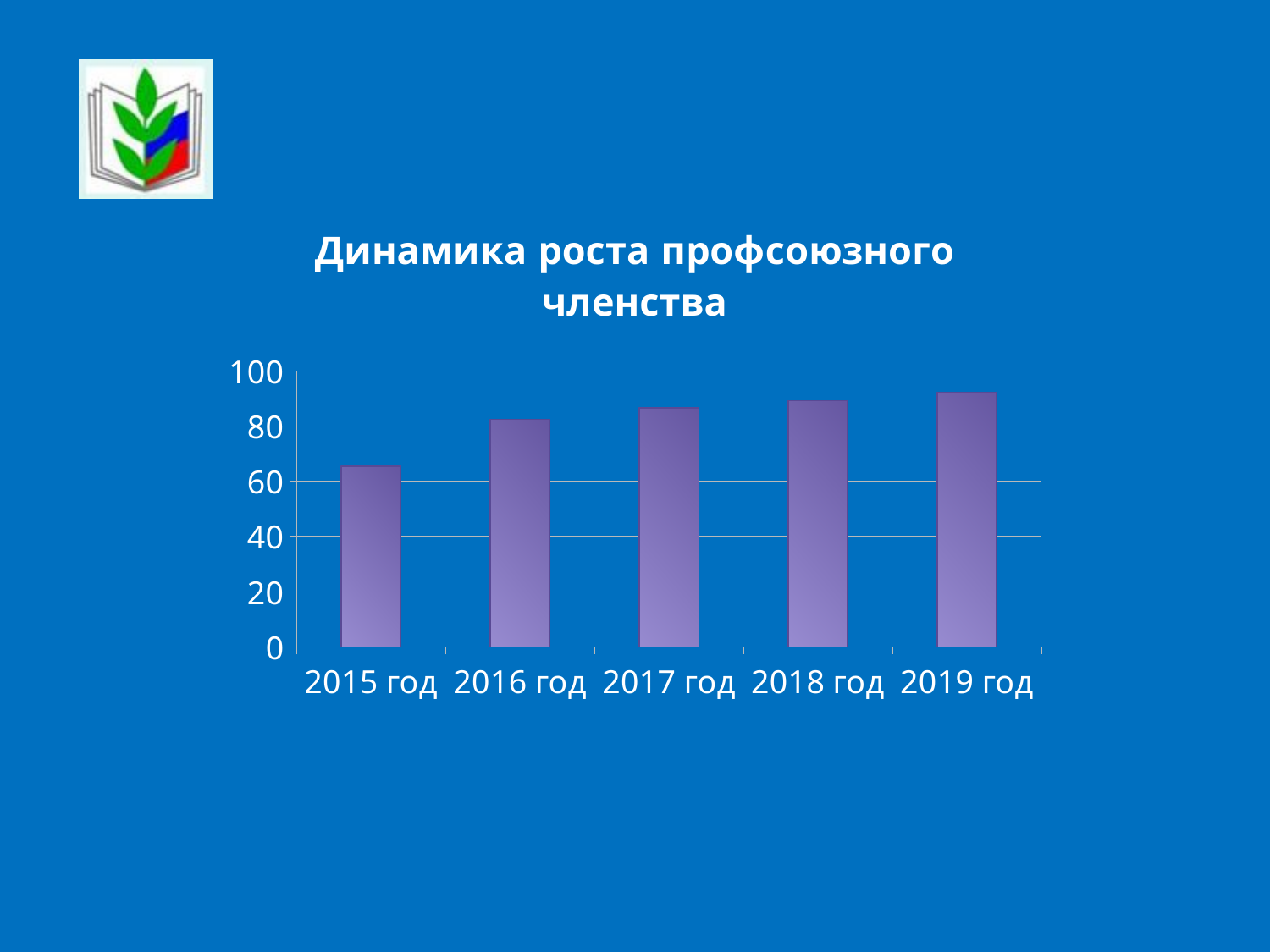
What kind of chart is shown on the slide? bar chart Which is larger, the value for 2016 год or the value for 2019 год? 2019 год Is the value for 2015 год greater or less than 60? greater Is the value for 2019 год greater or less than 100? less Which year has the lowest bar in the chart? 2015 год Is the value for 2017 год greater or less than 80? greater Do the values rise or fall from 2015 год to 2019 год? rise How many years (categories) are shown on the x axis of the chart? 5 Which is larger, the value for 2015 год or the value for 2017 год? 2017 год Which year has the highest bar in the chart? 2019 год What is the title of the chart? Динамика роста профсоюзного членства